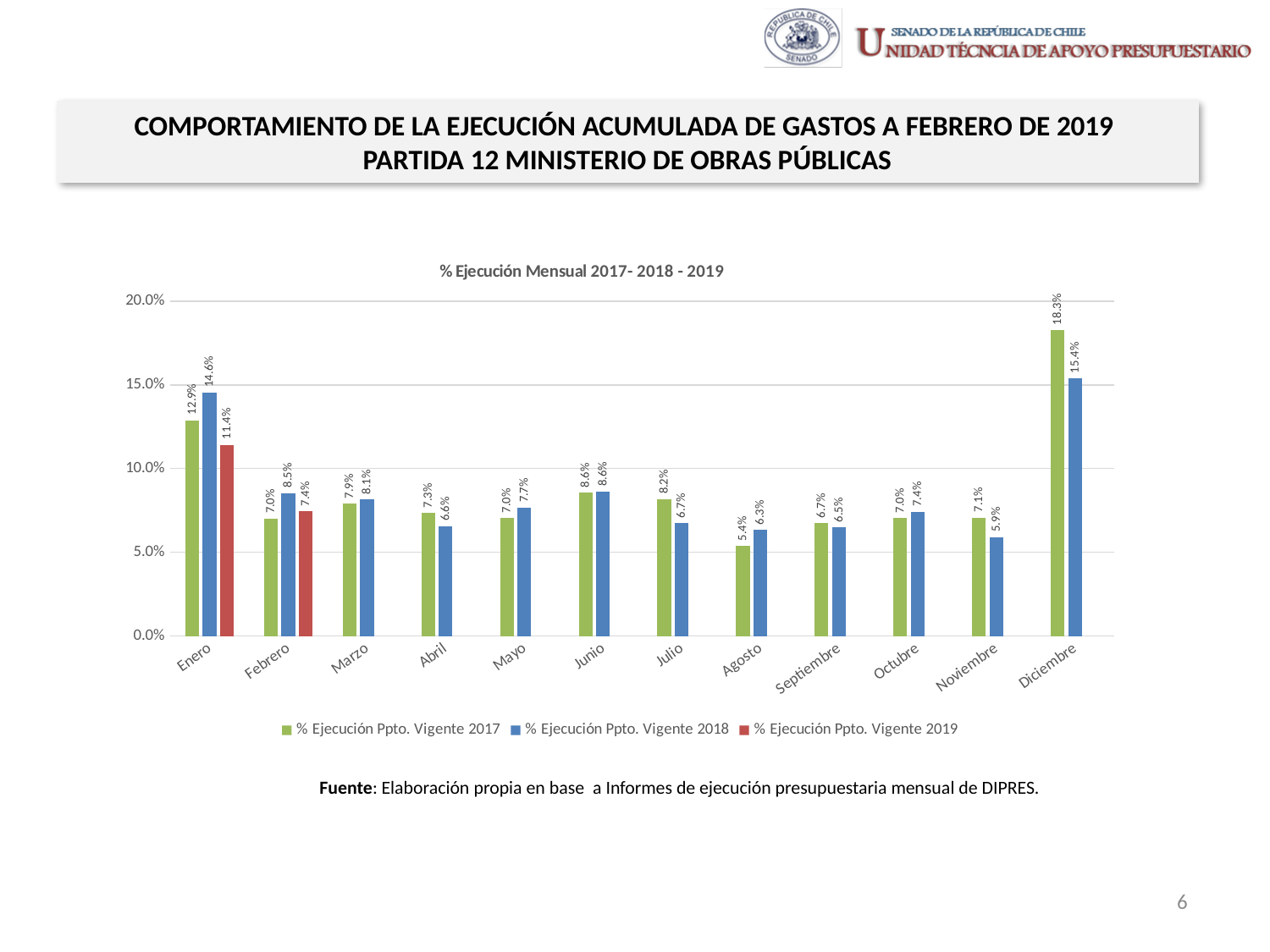
Which month has the lowest value for % Ejecución Ppto. Vigente 2018? Noviembre What is the value for % Ejecución Ppto. Vigente 2018 in Diciembre? 15.4% How many series does the legend list? 3 What is the title of the chart? % Ejecución Mensual 2017- 2018 - 2019 How many months are shown on the x axis? 12 What is the difference between the 2017 and 2018 values in Enero? 1.7% Which month has the highest value for % Ejecución Ppto. Vigente 2017? Diciembre Is the value for % Ejecución Ppto. Vigente 2017 in Diciembre greater or less than 15.0%? greater What is the value for % Ejecución Ppto. Vigente 2017 in Agosto? 5.4% In Julio, which is larger: the 2017 value or the 2018 value? 2017 What kind of chart is shown? bar chart What is the value for % Ejecución Ppto. Vigente 2019 in Enero? 11.4%